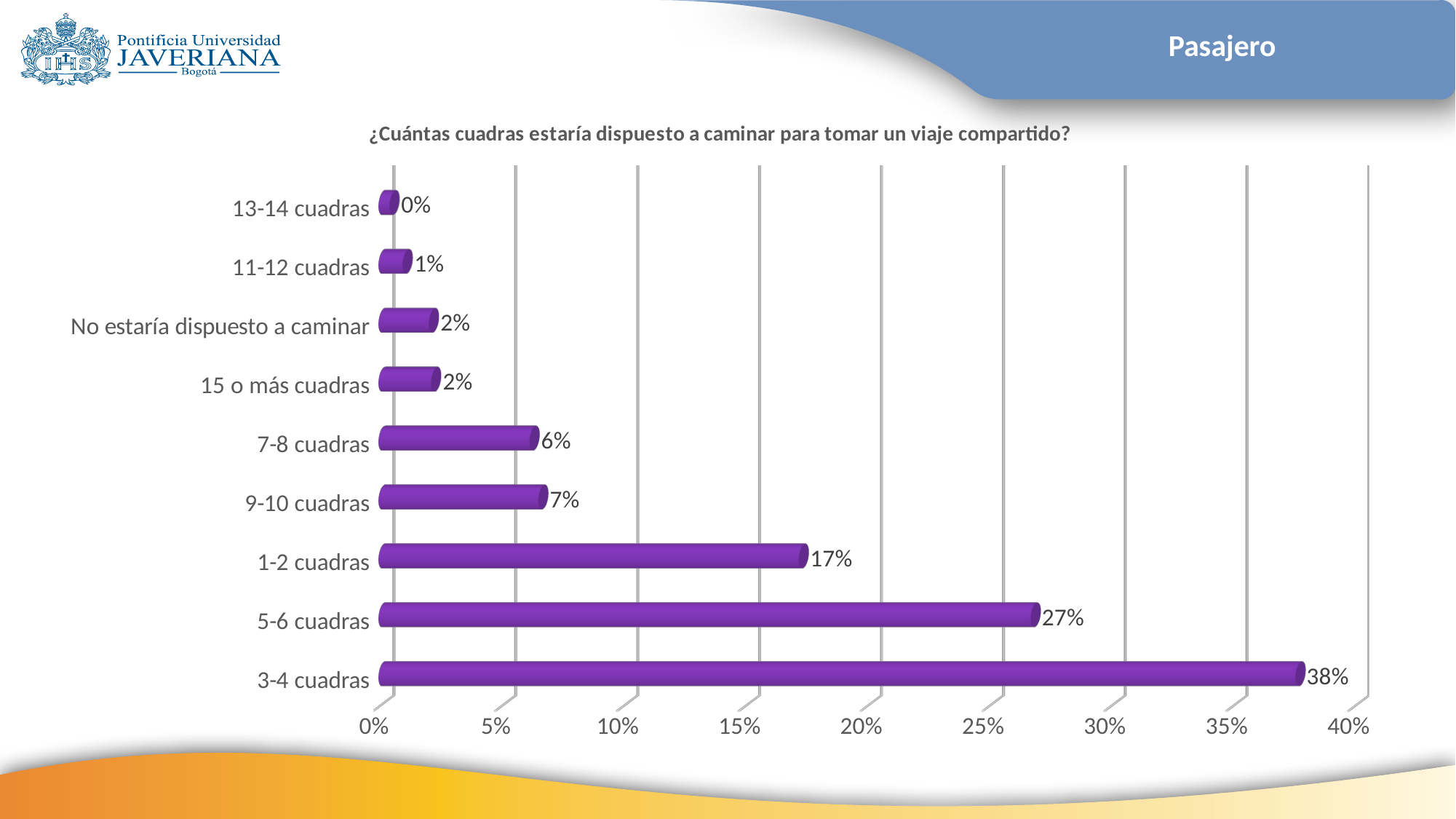
What percentage of respondents would walk 3-4 cuadras to take a shared ride? 38% Which is larger, the value for 9-10 cuadras or the value for 7-8 cuadras? 9-10 cuadras What percentage is shown for 1-2 cuadras? 17% What is the difference between the values for 3-4 cuadras and 5-6 cuadras? 11% Is the value for 5-6 cuadras greater or less than 25%? greater How many categories are shown in the chart? 9 What is the value for 'No estaría dispuesto a caminar'? 2% What is the title of the chart? ¿Cuántas cuadras estaría dispuesto a caminar para tomar un viaje compartido? Which category has the lowest value? 13-14 cuadras What kind of chart is shown on the slide? Bar chart What is the value shown for 5-6 cuadras? 27% Which category has the highest value? 3-4 cuadras